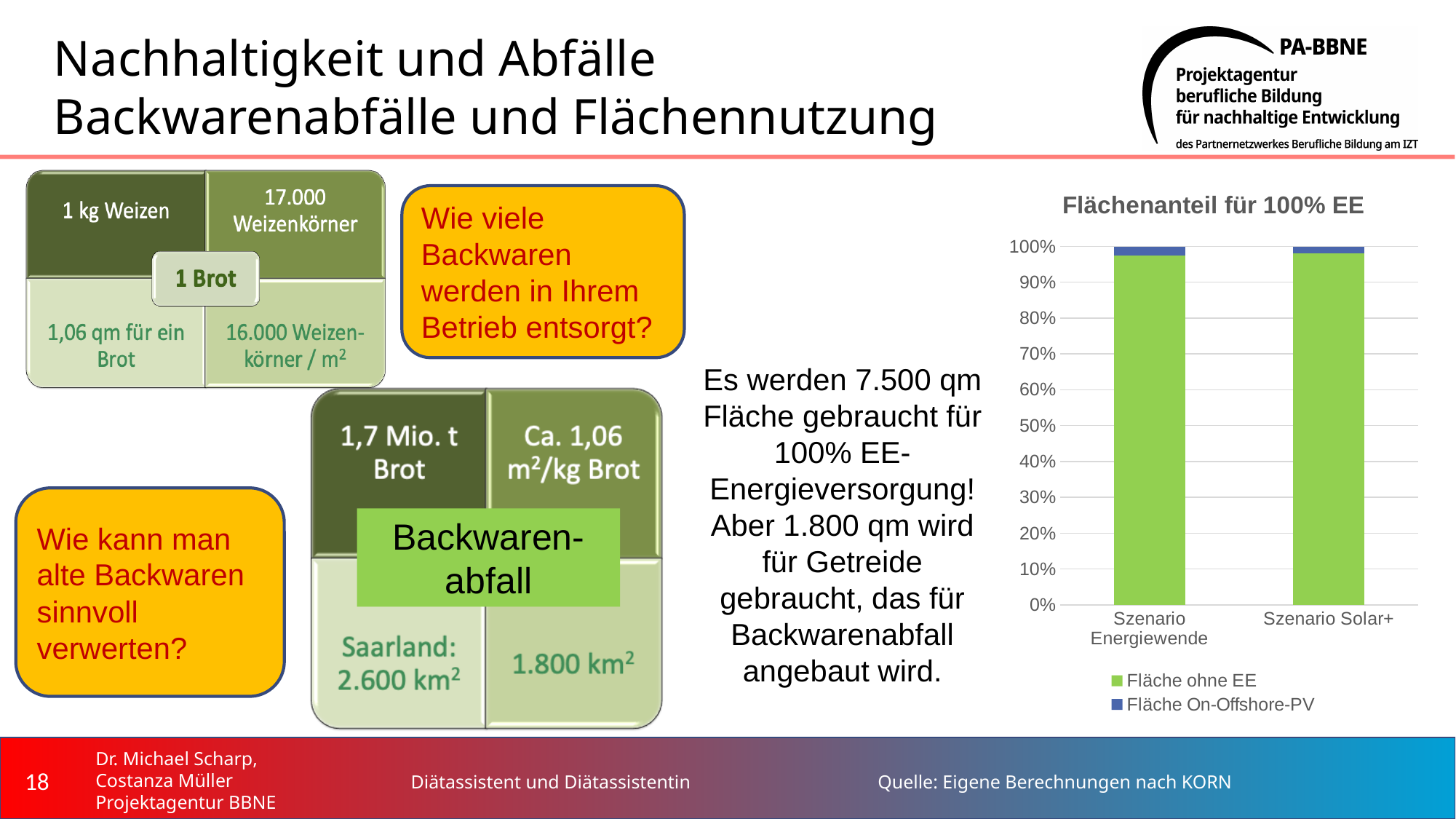
What is the highest value shown on the chart's y axis? 100% What kind of chart is shown on the slide? stacked bar chart What is the title of the chart on the slide? Flächenanteil für 100% EE Is the value for Fläche ohne EE in Szenario Energiewende greater or less than 90%? greater Is the value for Fläche ohne EE in Szenario Solar+ greater or less than 90%? greater In Szenario Energiewende, which series has the larger share: Fläche ohne EE or Fläche On-Offshore-PV? Fläche ohne EE How many scenarios (categories) are shown on the x axis of the chart? 2 How many series does the chart's legend list? 2 Is the value for Fläche On-Offshore-PV in Szenario Energiewende greater or less than 10%? less In Szenario Solar+, which series has the smaller share: Fläche ohne EE or Fläche On-Offshore-PV? Fläche On-Offshore-PV Which series is shown in green in the chart? Fläche ohne EE